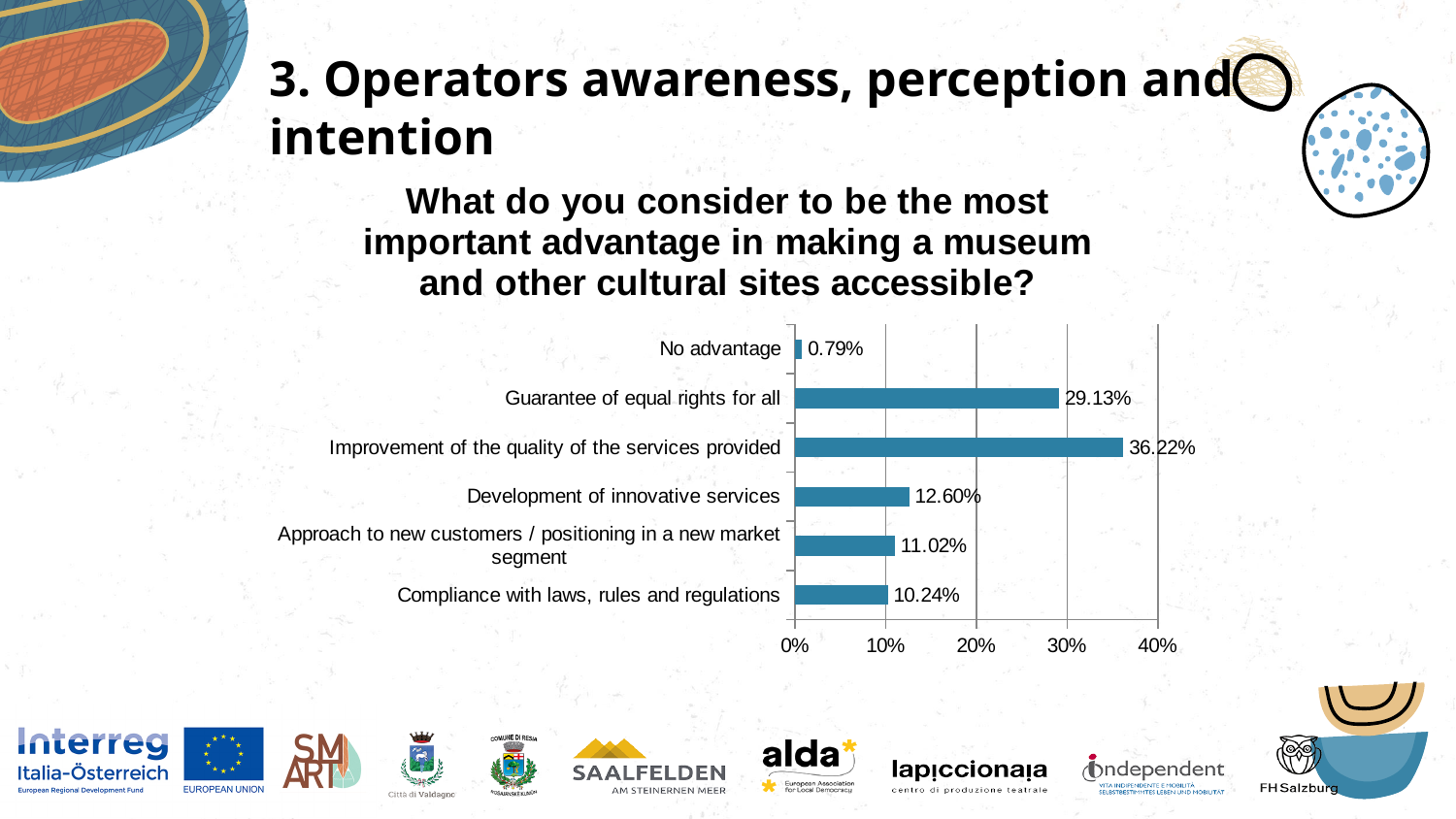
What percentage is shown for 'Compliance with laws, rules and regulations'? 10.24% What is the value shown for 'Development of innovative services'? 12.60% What is the value for 'No advantage'? 0.79% Is the value for 'Improvement of the quality of the services provided' greater or less than 30%? greater What type of chart is shown on the slide? Bar chart Which category has the lowest value in the chart? No advantage Which is larger: 'Development of innovative services' or 'Approach to new customers / positioning in a new market segment'? Development of innovative services Which category has the highest value in the chart? Improvement of the quality of the services provided What is the highest tick value shown on the horizontal axis? 40% What is the difference between 'Improvement of the quality of the services provided' and 'Guarantee of equal rights for all'? 7.09% How many categories are shown in the chart? 6 What percentage of respondents chose 'Guarantee of equal rights for all' as the most important advantage? 29.13%